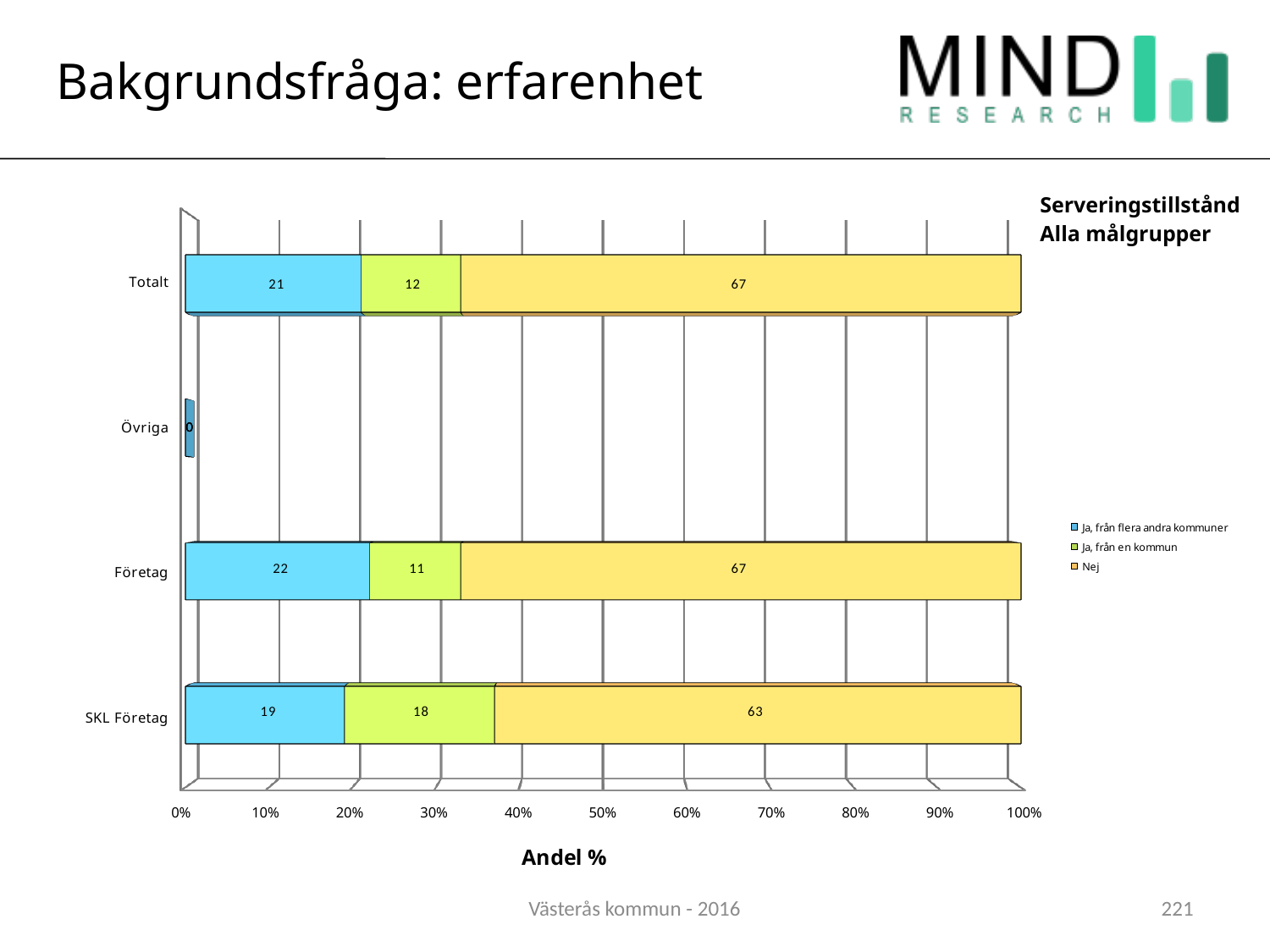
How many series does the legend list? 3 What value is labelled on the bar for Övriga? 0 Which is larger, the "Ja, från flera andra kommuner" value for Företag or for SKL Företag? Företag What is the value of "Ja, från en kommun" for SKL Företag? 18 What is the value of "Ja, från flera andra kommuner" for Företag? 22 Which category has the highest value for "Ja, från en kommun"? SKL Företag How many categories are shown on the vertical axis? 4 What is the difference between the "Ja, från en kommun" values for SKL Företag and Totalt? 6 What kind of chart is shown on the slide? Stacked bar chart What is the value of "Nej" for Totalt? 67 What is the label of the horizontal axis? Andel % Which category has the lowest value for "Nej" among Totalt, Företag and SKL Företag? SKL Företag